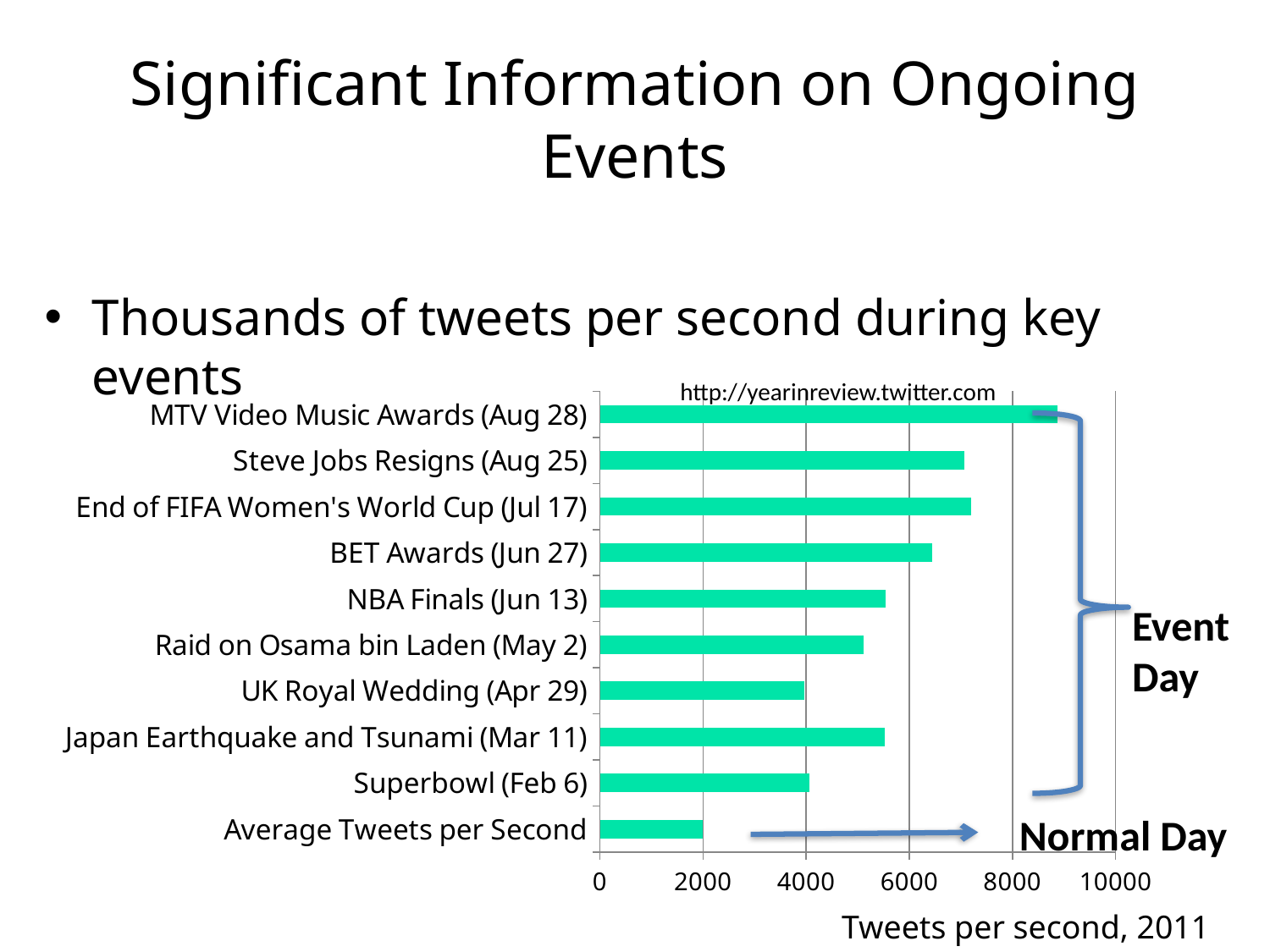
How many categories (bars) does the chart show? 10 Is the value for Steve Jobs Resigns (Aug 25) greater or less than 6000? greater Is the value for Average Tweets per Second greater or less than 4000? less Is the value for Raid on Osama bin Laden (May 2) greater or less than 6000? less Which category has the highest tweets per second? MTV Video Music Awards (Aug 28) Which is larger: the value for Superbowl (Feb 6) or MTV Video Music Awards (Aug 28)? MTV Video Music Awards (Aug 28) Which is larger: the value for BET Awards (Jun 27) or NBA Finals (Jun 13)? BET Awards (Jun 27) What is the title of the horizontal axis of the chart? Tweets per second, 2011 What kind of chart is shown on the slide? bar chart Which category has the lowest value in the chart? Average Tweets per Second